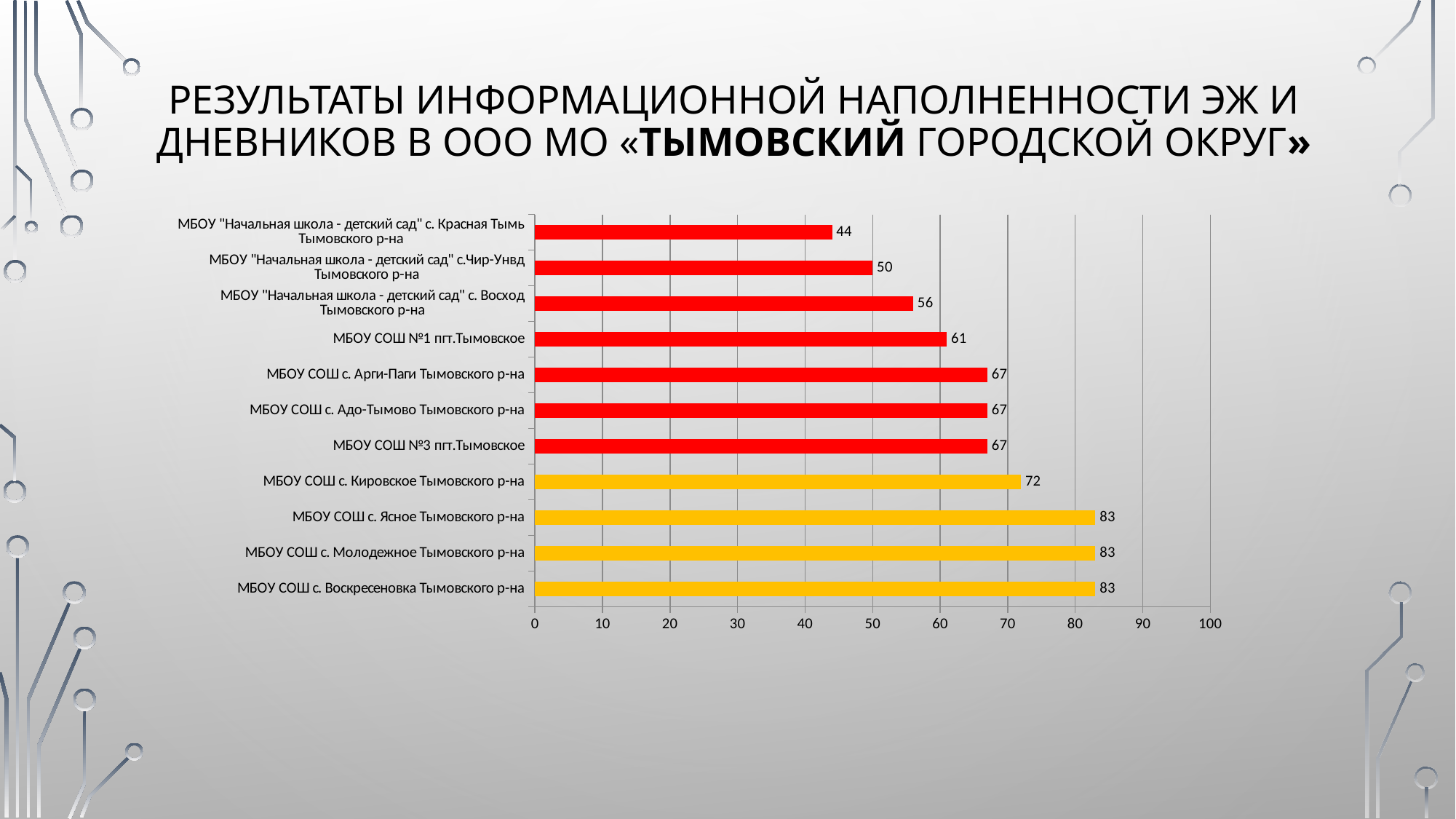
What is the highest value shown on the chart? 83 What is the value for МБОУ СОШ с. Арги-Паги Тымовского р-на? 67 What is the value for МБОУ СОШ с. Кировское Тымовского р-на? 72 What is the value for МБОУ "Начальная школа - детский сад" с. Восход Тымовского р-на? 56 How many categories are shown on the chart? 11 What is the value for МБОУ СОШ №1 пгт.Тымовское? 61 Which is larger: the value for МБОУ СОШ №3 пгт.Тымовское or the value for МБОУ СОШ №1 пгт.Тымовское? МБОУ СОШ №3 пгт.Тымовское How many bars are coloured yellow? 4 What kind of chart is shown on the slide? Bar chart What is the difference between the values for МБОУ "Начальная школа - детский сад" с.Чир-Унвд Тымовского р-на and МБОУ "Начальная школа - детский сад" с. Красная Тымь Тымовского р-на? 6 Which category has the lowest value? МБОУ "Начальная школа - детский сад" с. Красная Тымь Тымовского р-на What is the difference between the values for МБОУ СОШ с. Ясное Тымовского р-на and МБОУ СОШ с. Кировское Тымовского р-на? 11